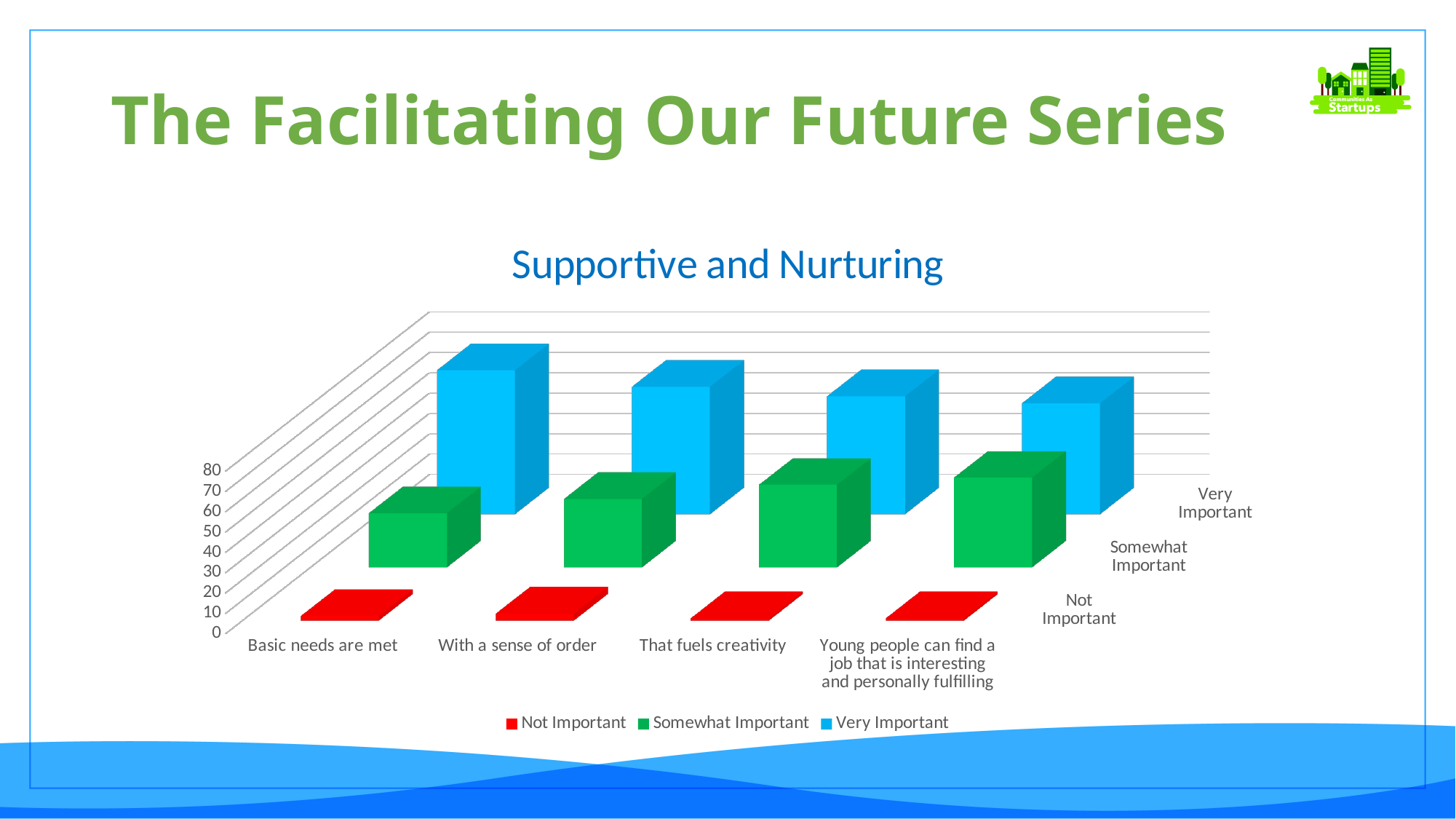
Which category has the lowest value for the Somewhat Important series? Basic needs are met Do the Very Important values rise or fall from left to right across the categories? fall How many categories are shown on the x axis? 4 Which category has the lowest value for the Very Important series? Young people can find a job that is interesting and personally fulfilling Which series is shown in red in the legend? Not Important How many series does the legend list? 3 What kind of chart is shown on the slide? 3D bar chart For Basic needs are met, which is larger: Very Important or Somewhat Important? Very Important Which category has the highest value for the Somewhat Important series? Young people can find a job that is interesting and personally fulfilling Which category has the highest value for the Very Important series? Basic needs are met What is the title of the chart? Supportive and Nurturing Is the Not Important value for Basic needs are met greater or less than 10? less